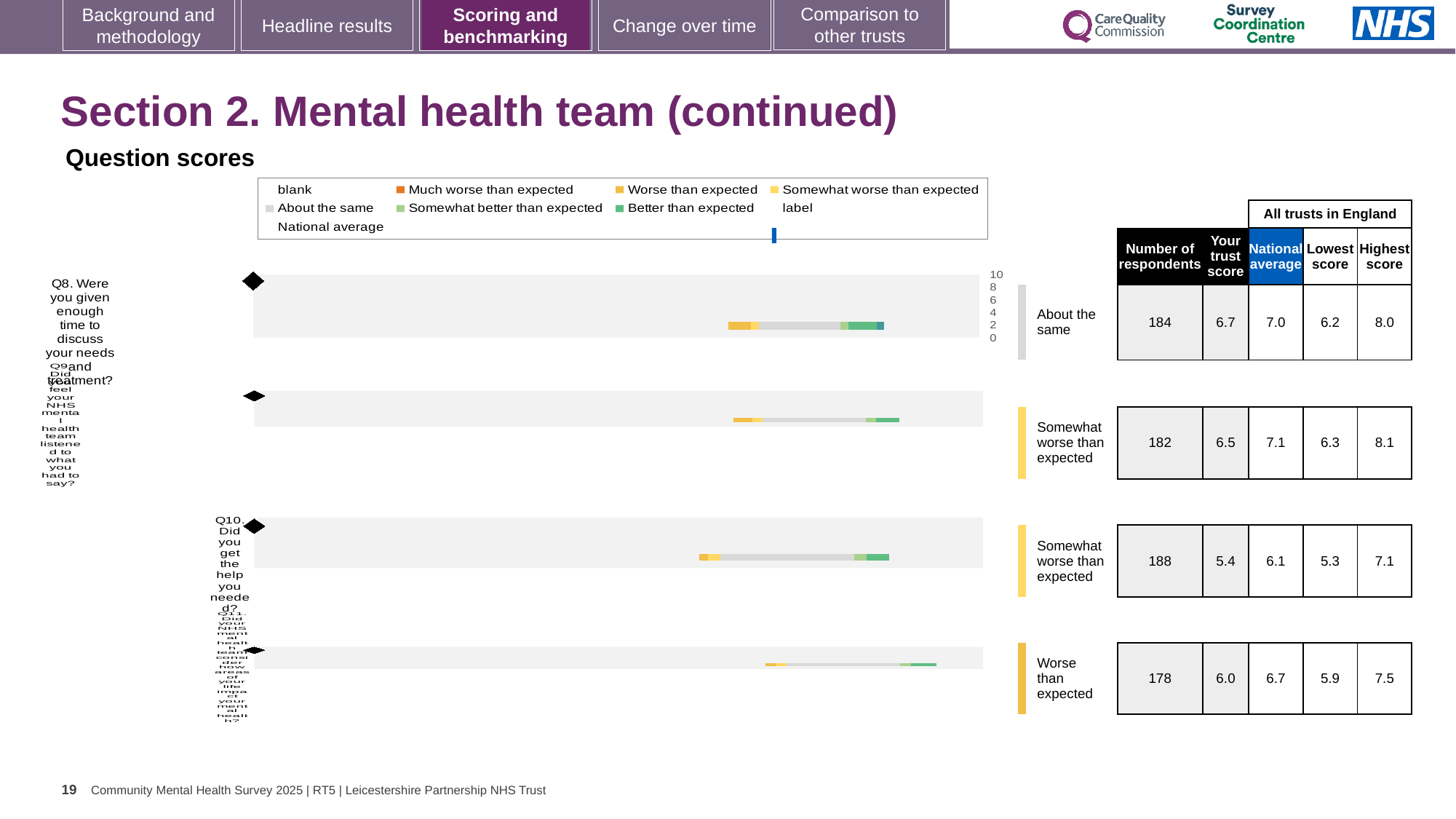
What is the number of respondents for Q8 (Were you given enough time to discuss your needs and treatment?)? 184 What is the highest score among all trusts in England for Q11? 7.5 In the legend, which colour represents 'Much worse than expected'? orange What benchmark category is shown next to the Q8 chart? About the same What kind of chart is used to show the question scores for Q8 to Q11? bar chart Which question has the most respondents? Q10 Which question has the lowest trust score? Q10 What is the difference between the national average and the trust score for Q10? 0.7 How many questions (Q8 to Q11) have a score chart on the slide? 4 For Q9, which is larger: the trust score or the national average? national average What is the national average score for Q9? 7.1 What is the trust score for Q10 (Did you get the help you needed?)? 5.4